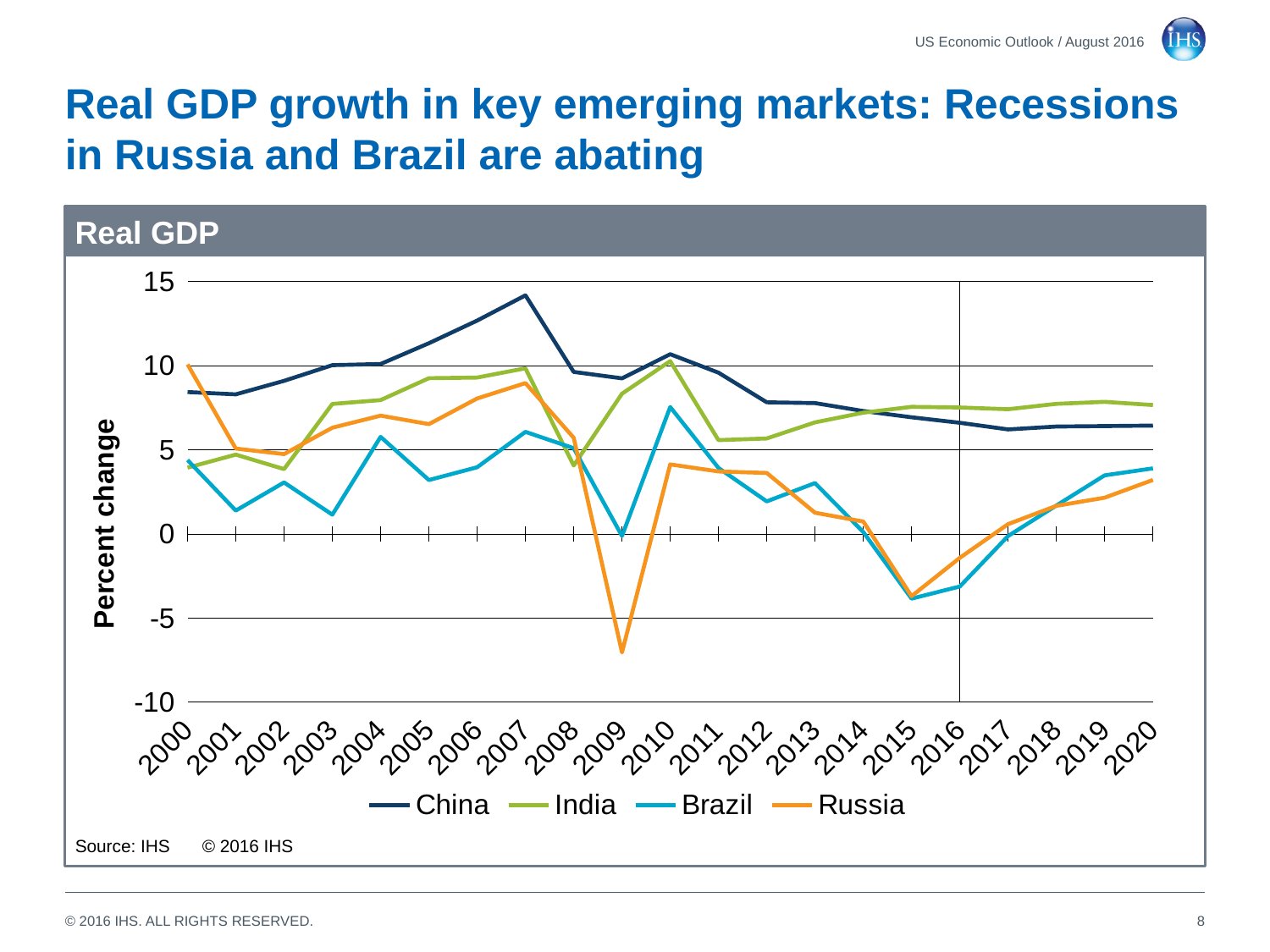
Which series has the highest value in 2007? China Is the value for India in 2015 greater or less than 5? greater What is the label on the y axis? Percent change Is the value for Brazil in 2015 greater or less than 0? less Is the value for China in 2007 greater or less than 10? greater How many series does the legend list? 4 How many years are plotted along the x axis? 21 What kind of chart is shown on the slide? line chart In 2009, which is larger, the value for Brazil or the value for Russia? Brazil Which series has the lowest value in 2009? Russia Does the China line rise or fall from 2010 to 2020? fall